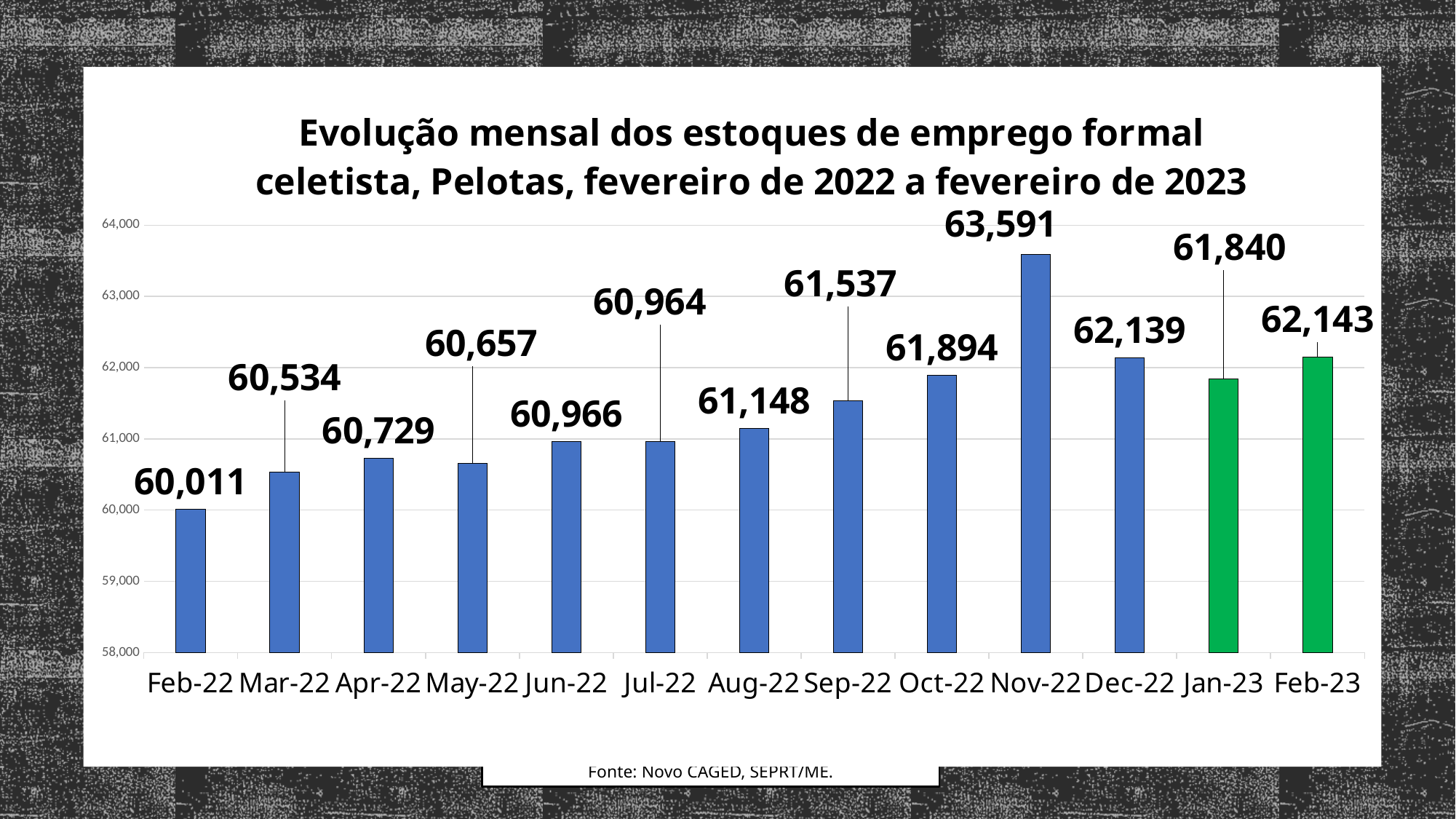
Which month has the lowest value? Feb-22 What is the difference between the values for Nov-22 and Dec-22? 1,452 Which month has the highest value? Nov-22 What kind of chart is shown on the slide? bar chart Which is larger, the value for Dec-22 or the value for Jan-23? Dec-22 What is the value for Feb-23? 62,143 What is the difference between the values for Feb-23 and Feb-22? 2,132 How many months are shown on the x axis? 13 Is the value for Nov-22 greater or less than 63,000? greater What is the value for May-22? 60,657 Which months are shown with green bars? Jan-23 and Feb-23 What is the value for Nov-22? 63,591